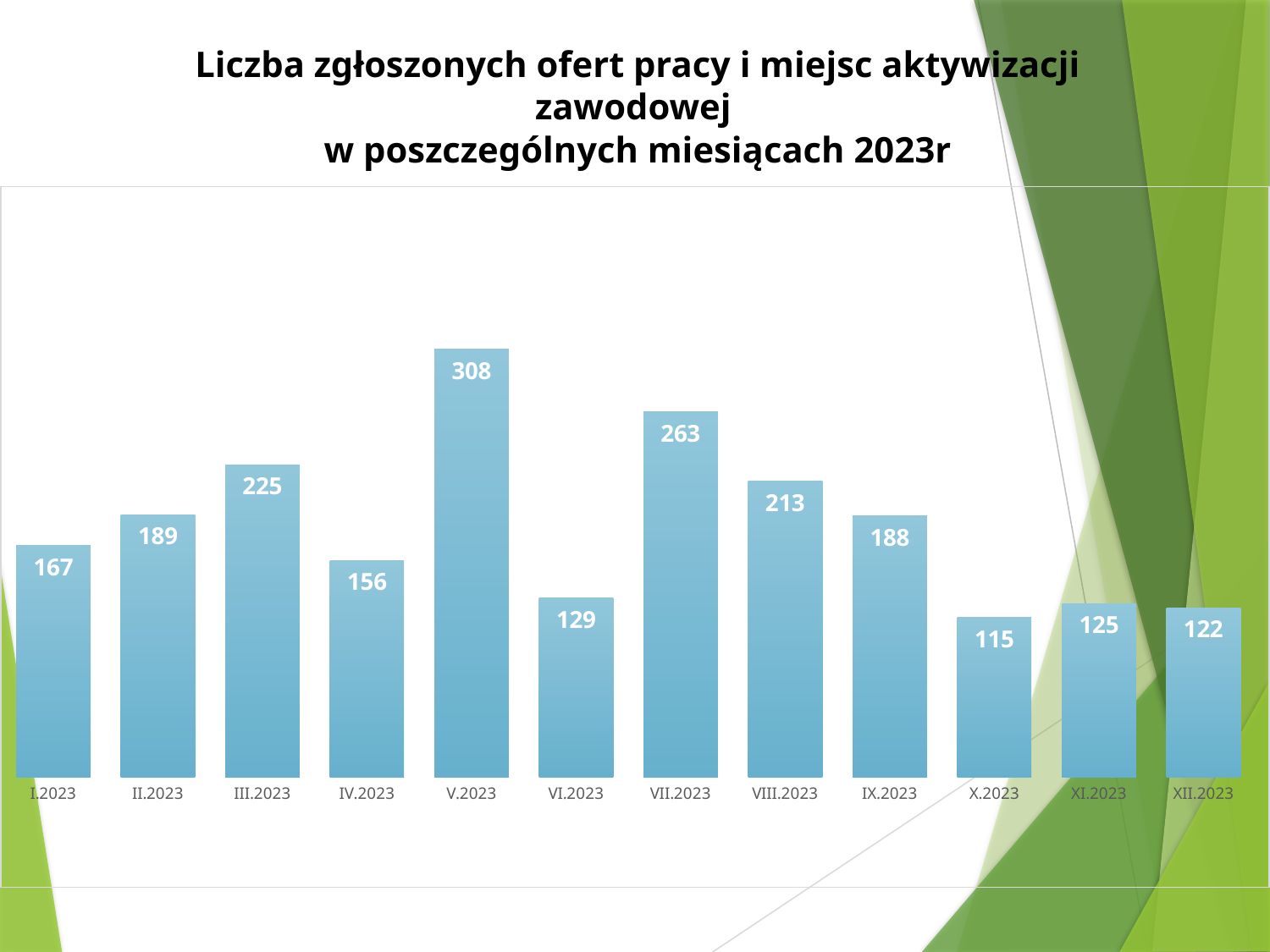
Which is larger, the value for II.2023 or the value for IX.2023? II.2023 What kind of chart is shown on the slide? bar chart How many months are shown on the x axis? 12 What is the difference between the values for V.2023 and VII.2023? 45 What is the value for I.2023? 167 What is the difference between the values for III.2023 and IV.2023? 69 What is the value for X.2023? 115 What is the value for V.2023? 308 What is the title of the chart? Liczba zgłoszonych ofert pracy i miejsc aktywizacji zawodowej w poszczególnych miesiącach 2023r Which month has the lowest value? X.2023 Do the values rise or fall from IX.2023 to X.2023? fall Which month has the highest value? V.2023